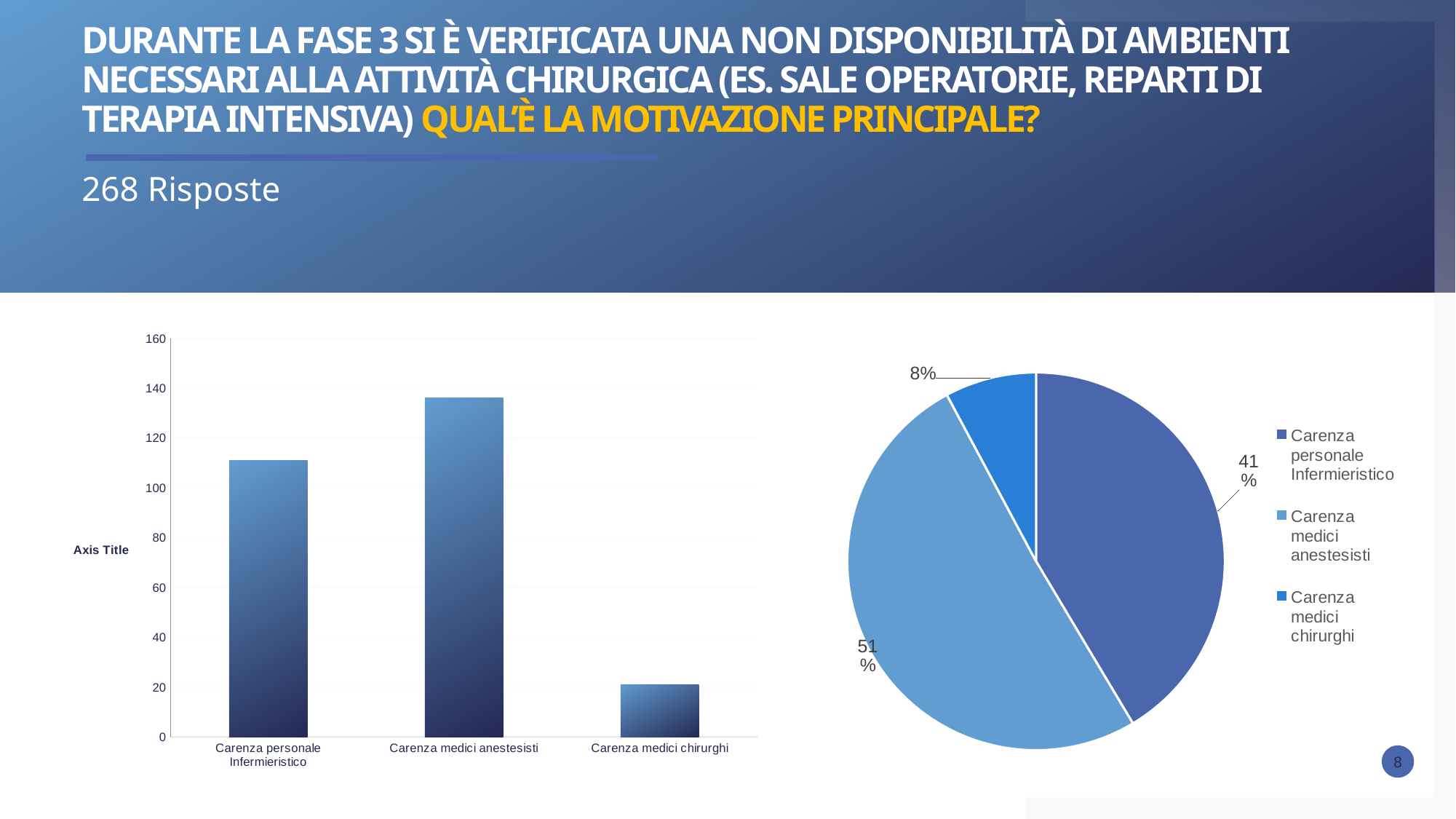
How many entries does the legend of the pie chart on the right list? 3 In the bar chart on the left, which category has the highest bar? Carenza medici anestesisti In the bar chart on the left, which category has the lowest bar? Carenza medici chirurghi In the bar chart on the left, is the value for Carenza medici chirurghi greater or less than 40? less What kind of chart is the chart on the right of the slide? pie chart In the pie chart on the right, what share does Carenza medici anestesisti have? 51% In the bar chart on the left, which is larger: the bar for Carenza personale Infermieristico or the bar for Carenza medici chirurghi? Carenza personale Infermieristico How many categories are shown in the bar chart on the left? 3 What kind of chart is the chart on the left of the slide? bar chart In the bar chart on the left, is the value for Carenza medici anestesisti greater or less than 140? less In the bar chart on the left, is the value for Carenza personale Infermieristico greater or less than 100? greater In the pie chart on the right, what share does Carenza medici chirurghi have? 8%